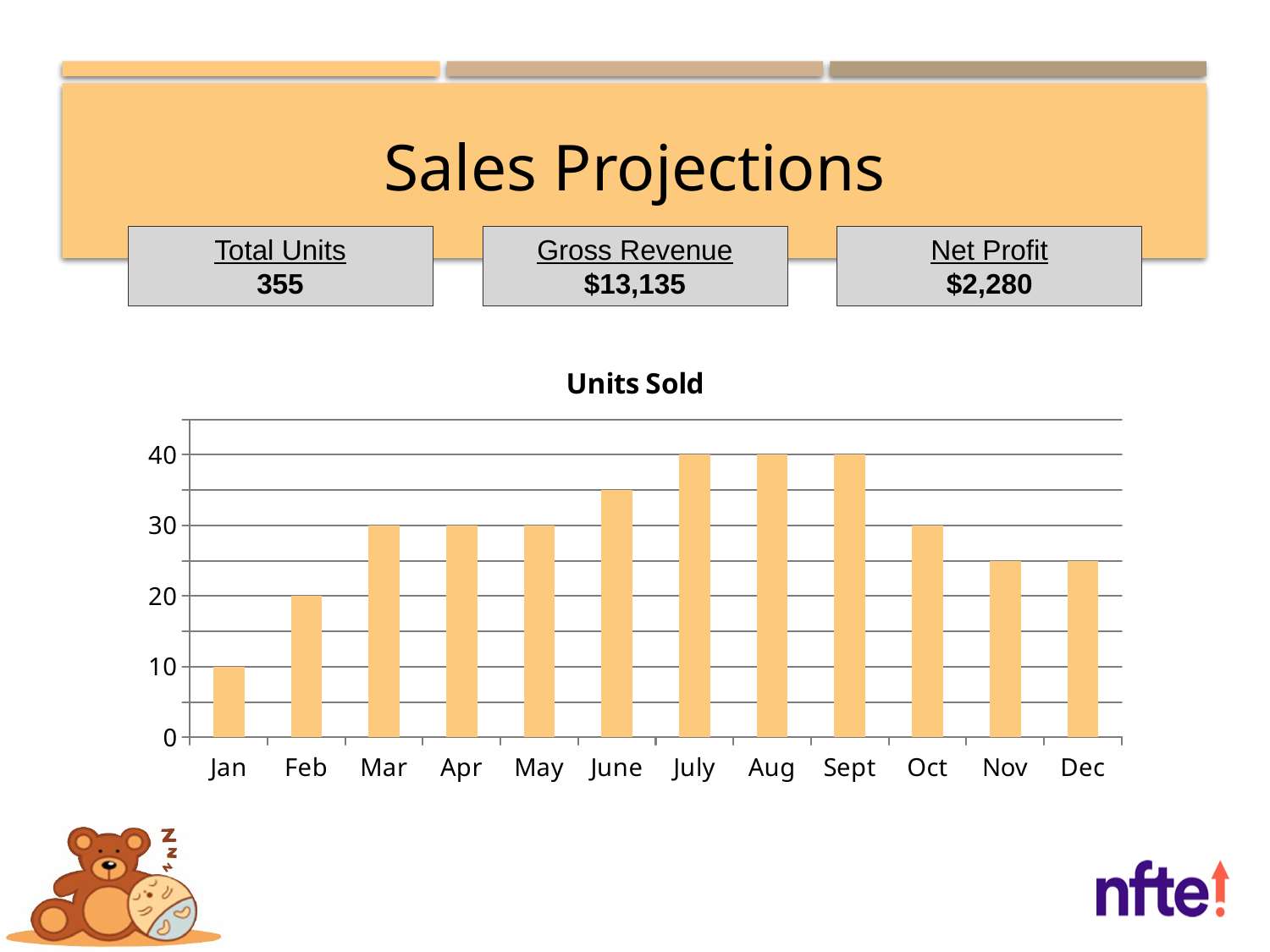
What is the value for Jan in the Units Sold chart? 10 Which is larger in the Units Sold chart, the value for Feb or the value for Oct? Oct Which month has the lowest value in the Units Sold chart? Jan Is the value for Nov in the Units Sold chart greater or less than 30? less What kind of chart is the Units Sold chart? bar chart Is the value for June in the Units Sold chart greater or less than 30? greater What is the value for Feb in the Units Sold chart? 20 What is the value for July in the Units Sold chart? 40 How many months are shown on the x axis of the Units Sold chart? 12 What is the difference between the values for Feb and Jan in the Units Sold chart? 10 What is the value for Mar in the Units Sold chart? 30 Do the values in the Units Sold chart rise or fall from Jan to July? rise